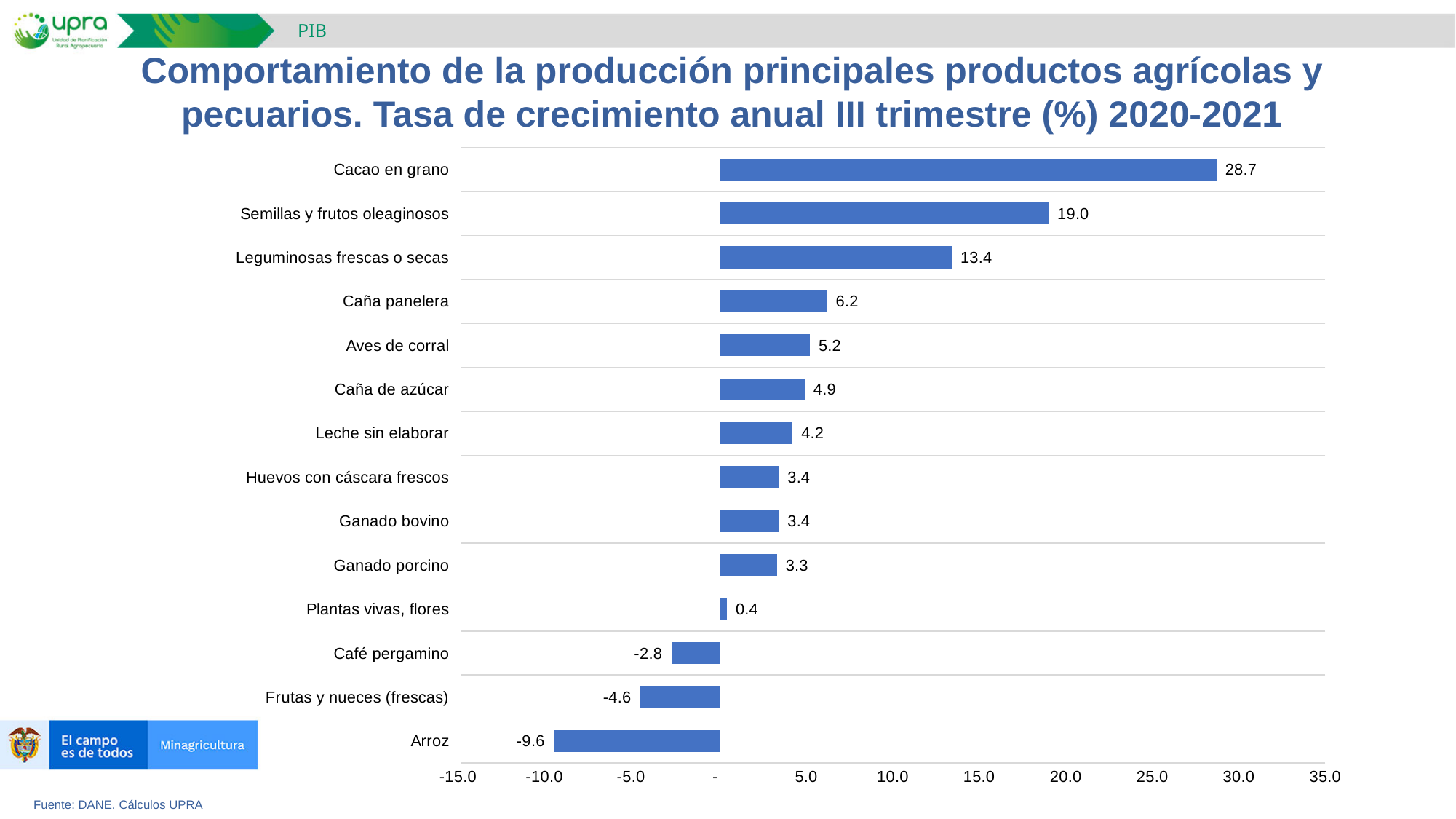
What is the source cited for the chart? DANE. Cálculos UPRA How many categories are shown in the chart? 14 Which is larger, the value for Caña panelera or the value for Aves de corral? Caña panelera What value is shown for Arroz? -9.6 What is the annual growth rate shown for Cacao en grano? 28.7 How many categories have a negative value? 3 Is the value for Leguminosas frescas o secas greater or less than 10.0? greater What is the difference between the values for Cacao en grano and Semillas y frutos oleaginosos? 9.7 What is the value for Leche sin elaborar? 4.2 Which category has the lowest value? Arroz What kind of chart is shown on the slide? Bar chart Which category has the highest growth rate? Cacao en grano